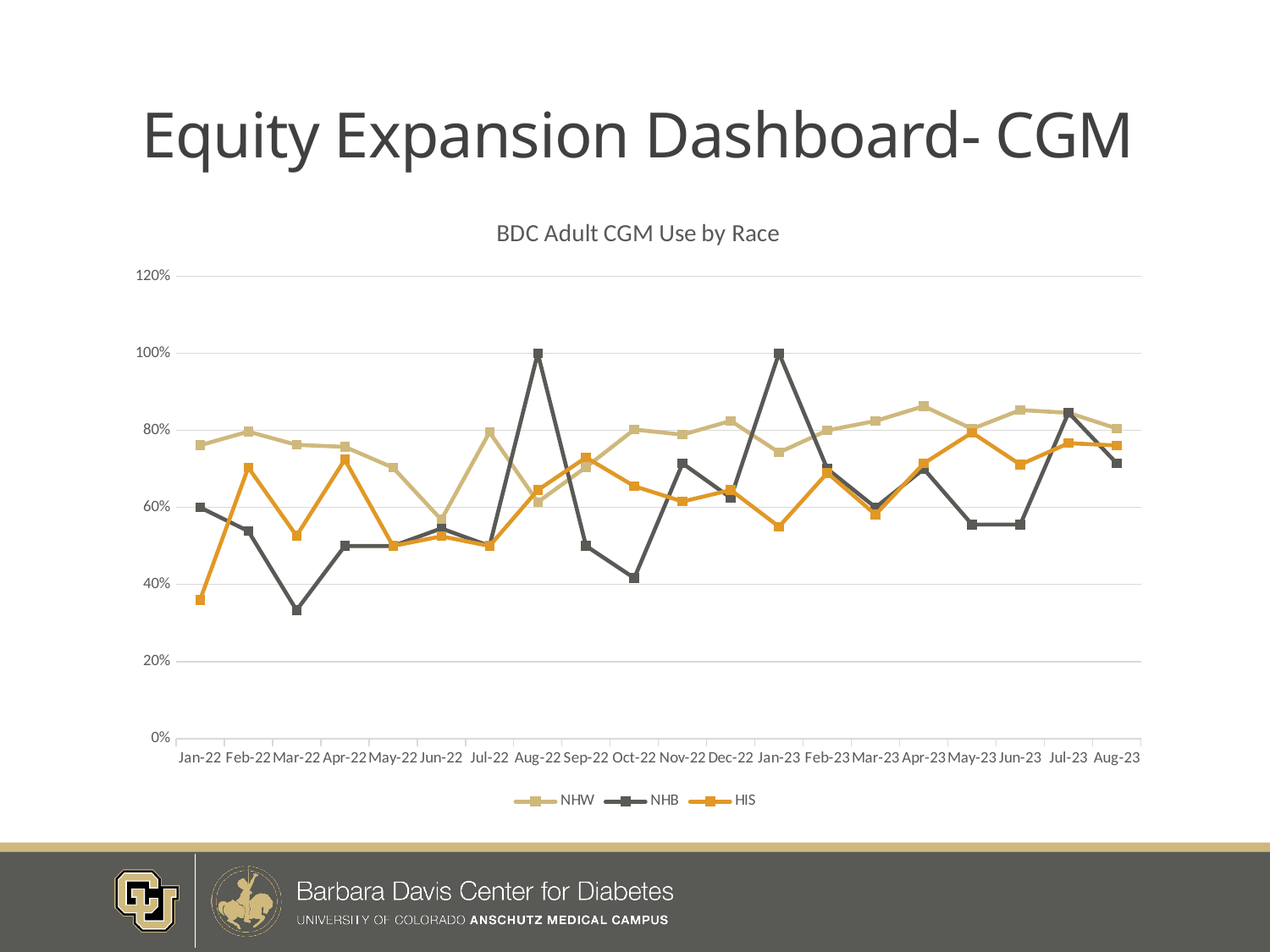
What is the title of the chart? BDC Adult CGM Use by Race Is the value for NHW in Apr-23 greater or less than 80%? greater How many series does the legend list? 3 What is the value for NHB in Aug-22? 100% How many months are shown along the x axis? 20 Which series reaches the highest value on the chart? NHB In Jan-22, which series has the higher value, NHW or NHB? NHW Is the value for HIS in Jan-22 greater or less than 40%? less In which month does the NHB series reach its lowest value? Mar-22 What is the value for NHB in Jan-23? 100% What type of chart is shown on the slide? line chart Does the HIS series rise or fall overall from Jan-22 to Aug-23? rise